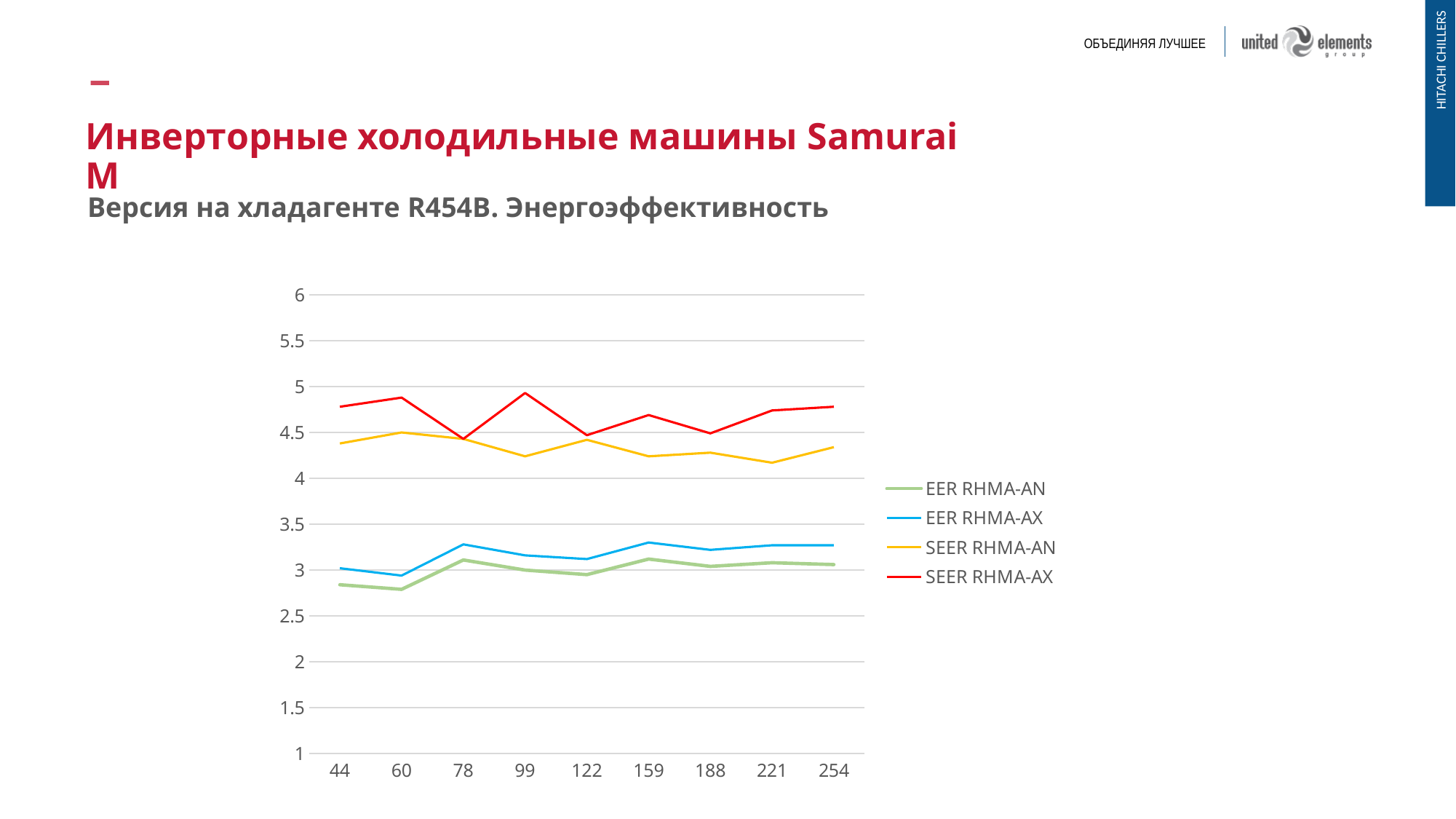
What colour is the SEER RHMA-AX line in the legend? red What kind of chart is shown on the slide? line chart How many series does the legend list? 4 How many points are plotted along the x axis for each series? 9 Is the value of EER RHMA-AX at 78 greater or less than 3? greater Is the value of SEER RHMA-AN at 221 greater or less than 4.5? less Is the value of EER RHMA-AN at 44 greater or less than 3? less At 254, which is larger: EER RHMA-AX or EER RHMA-AN? EER RHMA-AX At which x-axis category is EER RHMA-AX lowest? 60 Does EER RHMA-AX rise or fall from 60 to 78? rise At 44, which is larger: SEER RHMA-AX or SEER RHMA-AN? SEER RHMA-AX